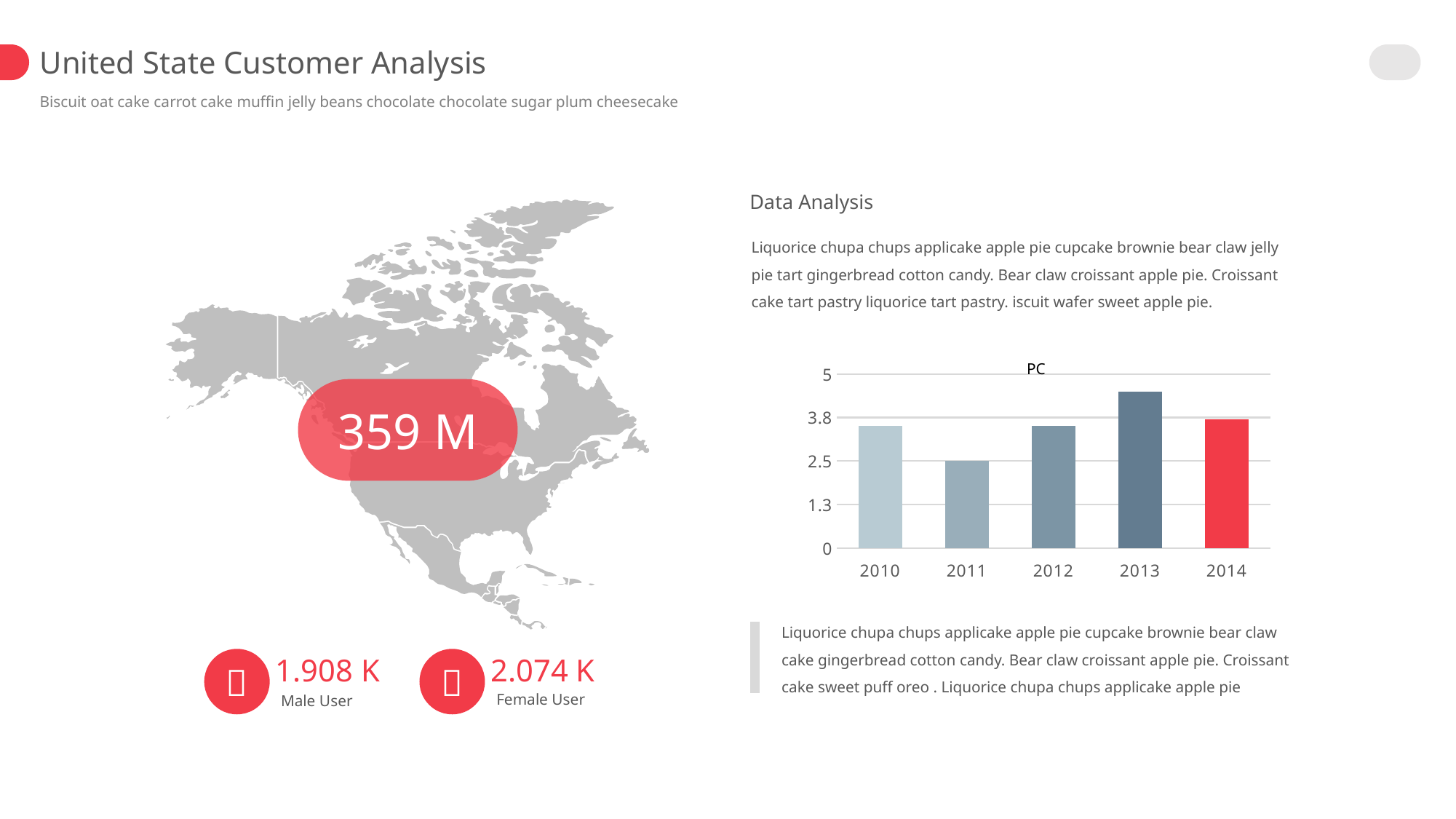
What colour is the bar for 2014 in the chart? Red Which year has the highest bar in the chart? 2013 Is the value for 2011 greater or less than 3.8? less What is the value for 2011 in the chart? 2.5 Is the value for 2010 greater or less than 2.5? greater How many years are shown on the x axis of the chart? 5 What is the title of the chart? PC Is the value for 2013 greater or less than 3.8? greater Which year has the lowest bar in the chart? 2011 Which is larger, the value for 2013 or the value for 2011? 2013 Which is larger, the value for 2014 or the value for 2011? 2014 What kind of chart is shown on the slide? Bar chart